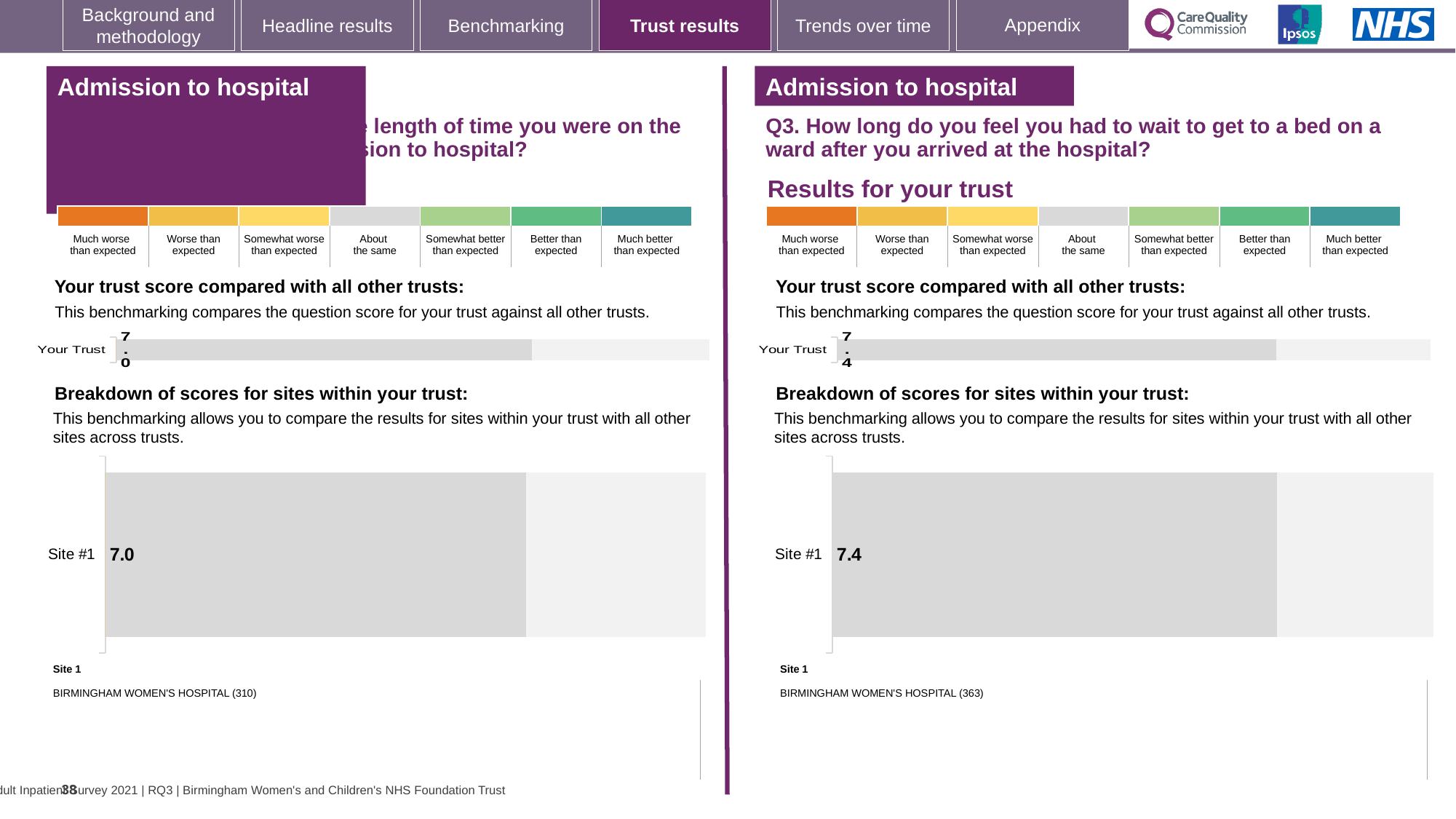
What is the difference between the Site #1 score on the right half of the slide (Q3) and the Site #1 score on the left half? 0.4 On the right half of the slide (Q3), which site name is listed as Site 1 below the chart? BIRMINGHAM WOMEN'S HOSPITAL (363) What kind of chart is used to show the Site #1 score on the right half of the slide? Bar chart On the right half of the slide (Q3), what score is shown for Site #1 in the 'Breakdown of scores for sites within your trust' chart? 7.4 On the right half of the slide (Q3), is the Site #1 score the same as the Your Trust score? Yes Which is larger: the Your Trust score on the left half of the slide or the Your Trust score on the right half (Q3)? Right half (Q3) On the right half of the slide (Q3), what is the score shown for Your Trust in the 'Your trust score compared with all other trusts' chart? 7.4 How many sites are shown in the 'Breakdown of scores for sites within your trust' chart on the left half of the slide? 1 On the left half of the slide, which site name is listed as Site 1 below the chart? BIRMINGHAM WOMEN'S HOSPITAL (310) How many sites are shown in the 'Breakdown of scores for sites within your trust' chart on the right half of the slide (Q3)? 1 On the left half of the slide, what score is shown for Site #1 in the 'Breakdown of scores for sites within your trust' chart? 7.0 On the left half of the slide, what is the score shown for Your Trust in the 'Your trust score compared with all other trusts' chart? 7.0